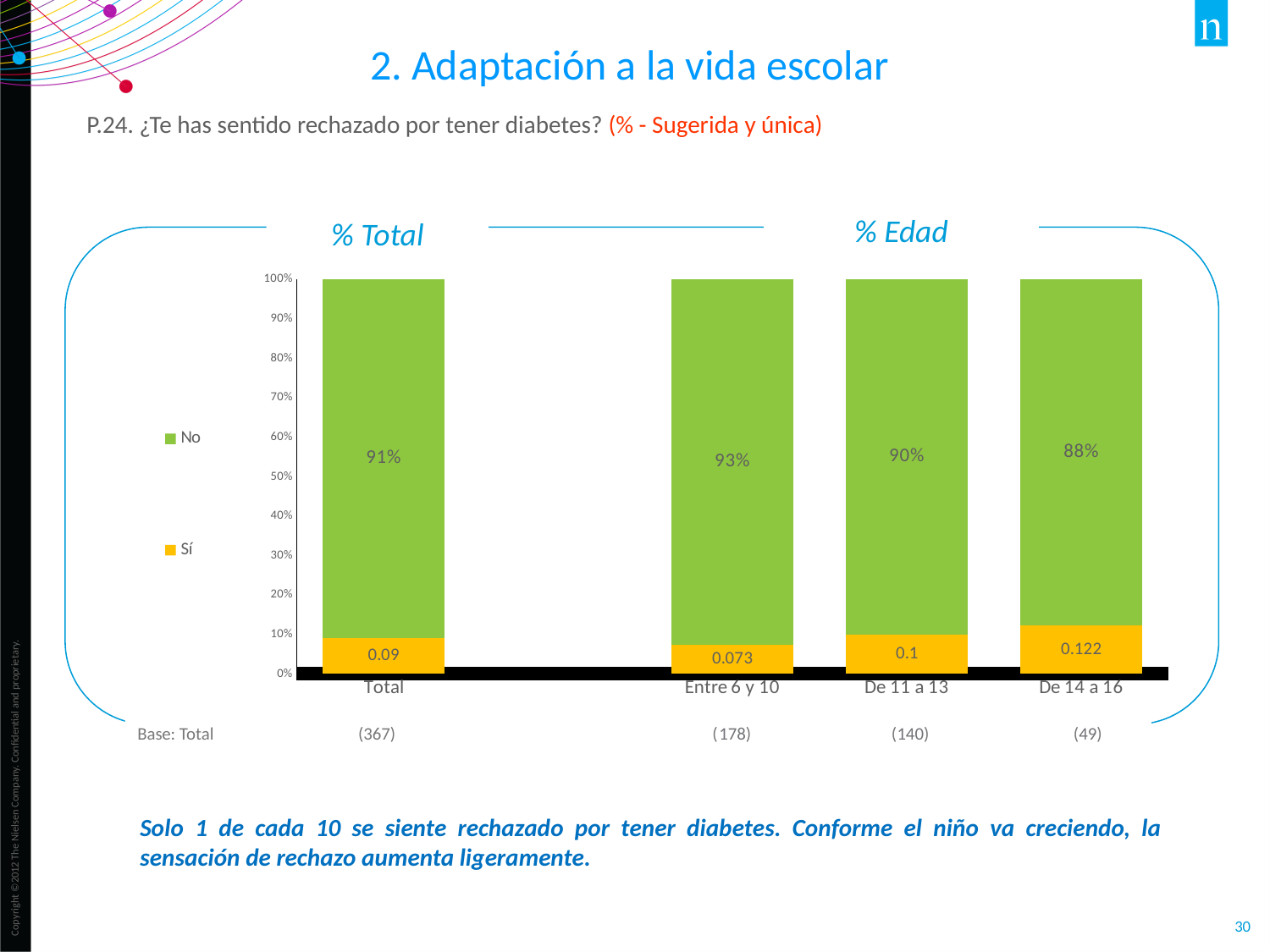
How many bars (categories) are shown in the chart? 4 Which is larger, the "Sí" value for "De 11 a 13" or for "De 14 a 16"? De 14 a 16 What is the difference between the "No" values for "Entre 6 y 10" and "De 14 a 16"? 5% What kind of chart is shown on the slide? Stacked bar chart What is the value of the "No" segment for the "De 11 a 13" bar? 90% Which category has the lowest "No" value? De 14 a 16 What is the value of the "Sí" segment for the "De 14 a 16" bar? 0.122 How many series does the legend list? 2 What is the value of the "No" segment for the "Total" bar? 91% Which age group has the highest "No" value? Entre 6 y 10 What is the value of the "Sí" segment for the "Entre 6 y 10" bar? 0.073 Which category has the lowest "Sí" value? Entre 6 y 10